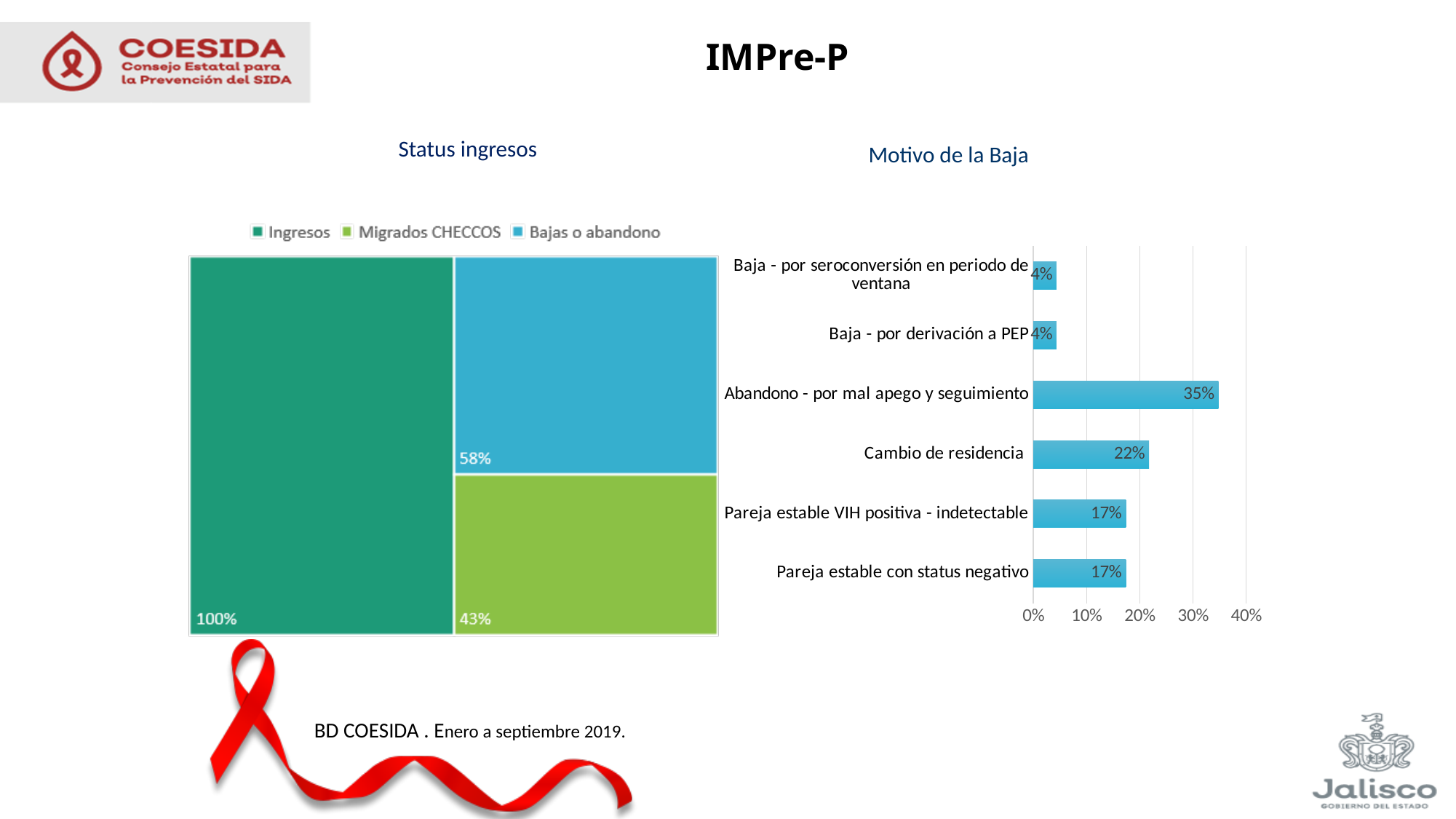
In the 'Status ingresos' chart, what is the value for 'Migrados CHECCOS'? 43% In the 'Status ingresos' chart, what is the difference between 'Bajas o abandono' and 'Migrados CHECCOS'? 15% What kind of chart is the 'Motivo de la Baja' chart? Bar chart In the 'Motivo de la Baja' chart, what is the difference between 'Abandono - por mal apego y seguimiento' and 'Cambio de residencia'? 13% In the 'Motivo de la Baja' chart, what is the value for 'Abandono - por mal apego y seguimiento'? 35% In the 'Motivo de la Baja' chart, what is the value for 'Cambio de residencia'? 22% In the 'Motivo de la Baja' chart, which category has the highest value? Abandono - por mal apego y seguimiento In the 'Motivo de la Baja' chart, is the value for 'Abandono - por mal apego y seguimiento' greater or less than 30%? greater How many categories are shown in the 'Motivo de la Baja' chart? 6 In the 'Motivo de la Baja' chart, which is larger: 'Cambio de residencia' or 'Pareja estable con status negativo'? Cambio de residencia In the 'Status ingresos' chart, what is the value for 'Bajas o abandono'? 58% How many series does the legend of the 'Status ingresos' chart list? 3